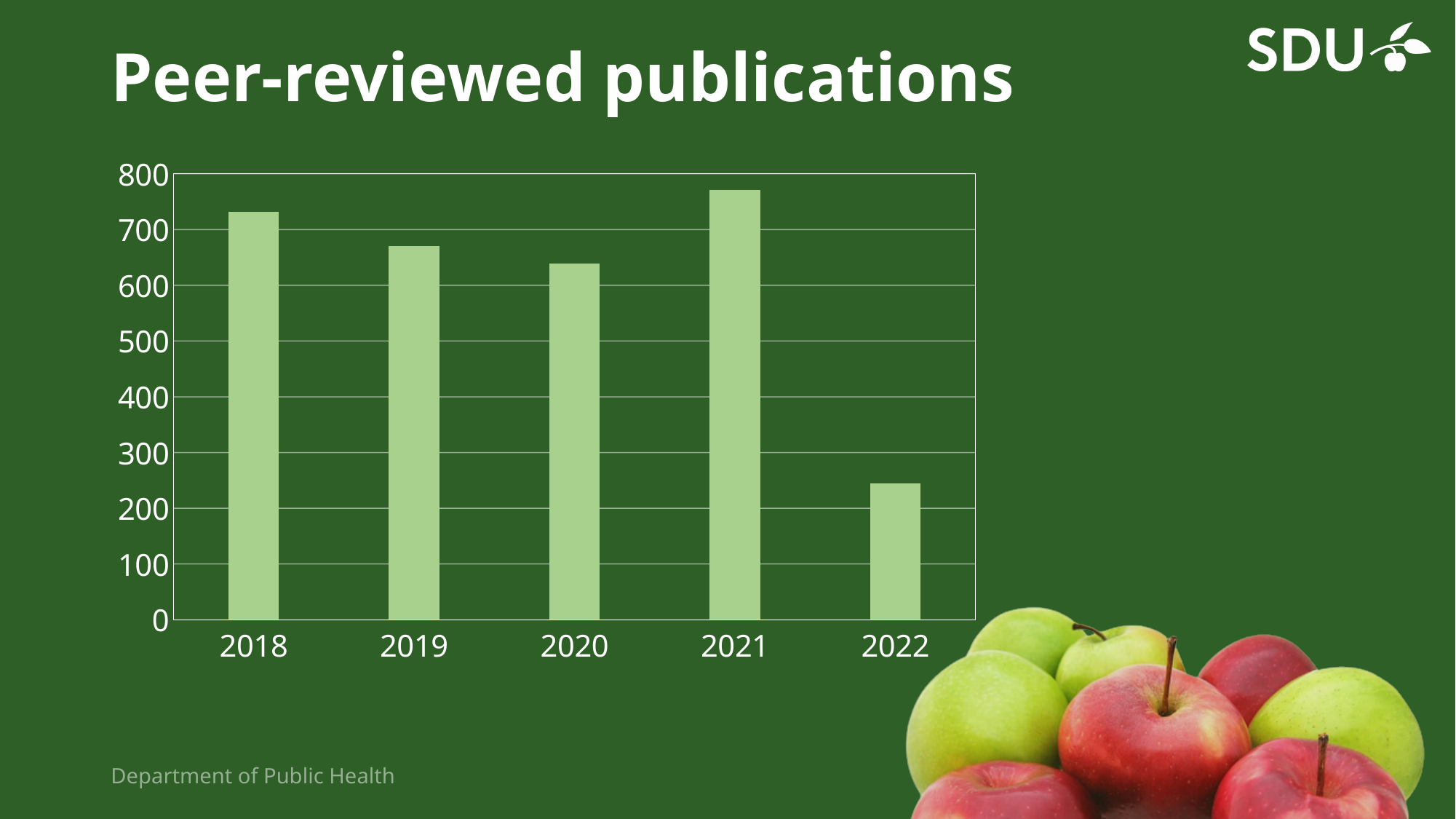
Which year has more peer-reviewed publications, 2018 or 2019? 2018 Is the value for 2022 greater or less than 300? less Is the value for 2019 greater or less than 700? less Do the values rise or fall from 2018 to 2020? fall How many years are shown on the x axis of the chart? 5 Which year has the highest number of peer-reviewed publications? 2021 What kind of chart is shown on the slide? Bar chart Which year has more peer-reviewed publications, 2021 or 2022? 2021 Which year has the lowest number of peer-reviewed publications? 2022 What is the title of the slide containing the chart? Peer-reviewed publications Is the value for 2020 greater or less than 600? greater